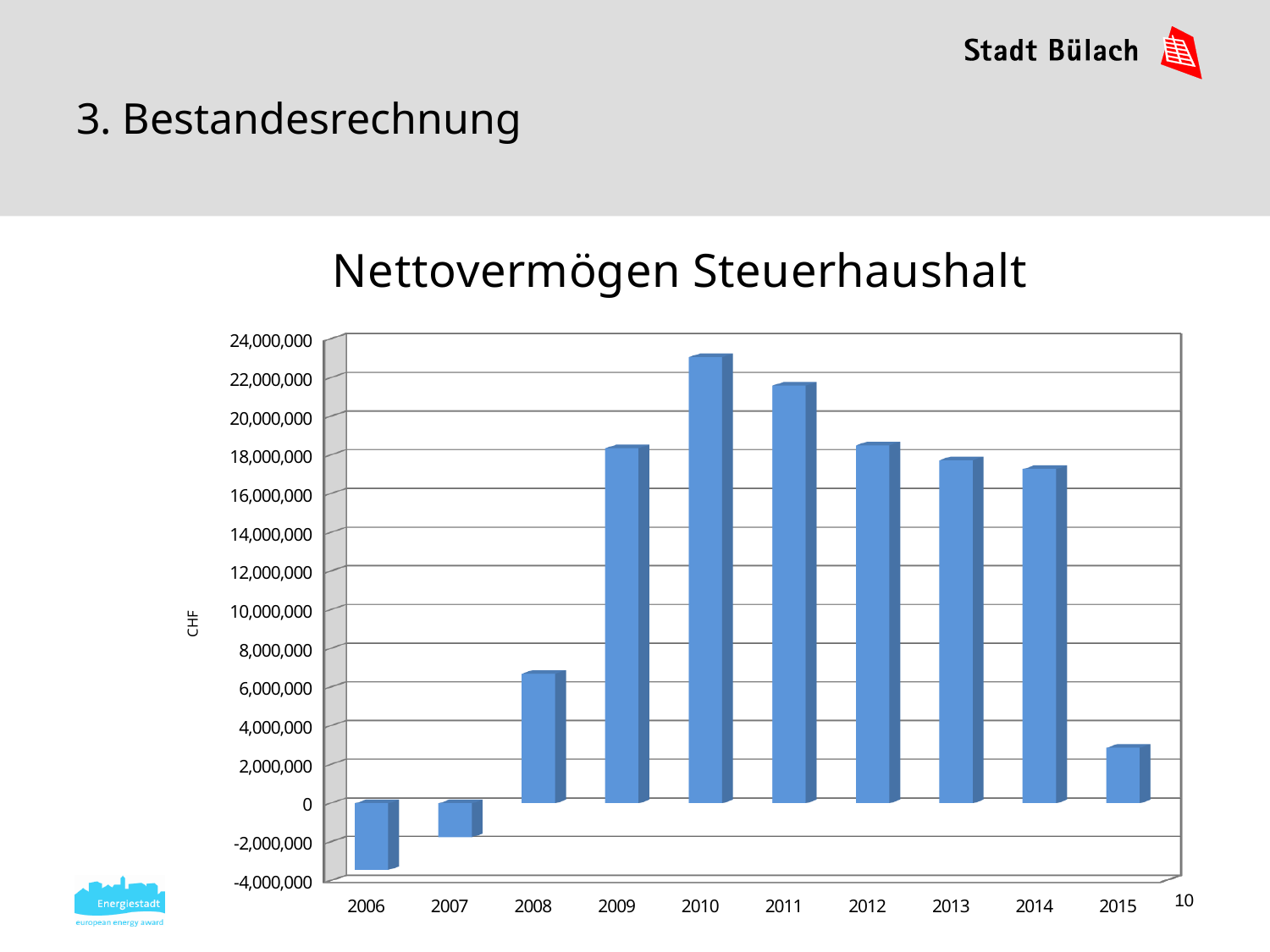
What is the title of the chart? Nettovermögen Steuerhaushalt Which year has the lowest Nettovermögen Steuerhaushalt? 2006 Is the value for 2010 greater or less than 22,000,000? greater How many years are shown on the x axis of the chart? 10 Do the values rise or fall from 2010 to 2015? fall Which year has the larger value, 2011 or 2012? 2011 Is the value for 2006 greater or less than -2,000,000? less Is the value for 2008 greater or less than 8,000,000? less What unit is shown on the vertical axis label of the chart? CHF Which year has the highest Nettovermögen Steuerhaushalt? 2010 What type of chart is shown on the slide? Bar chart